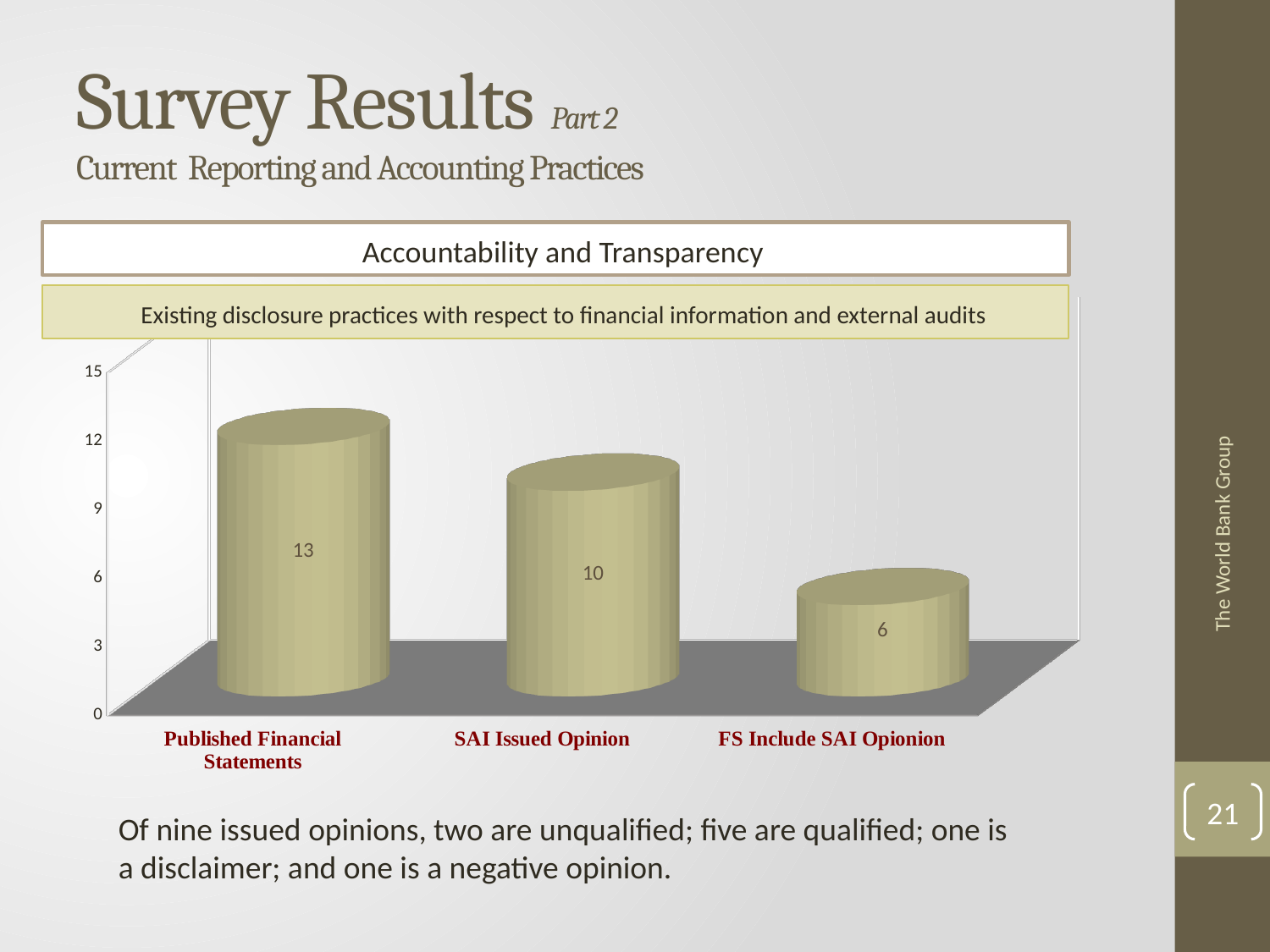
How many categories are shown in the chart? 3 What is the value for Published Financial Statements? 13 Which category has the highest value? Published Financial Statements What is the difference between the values for SAI Issued Opinion and FS Include SAI Opionion? 4 What is the value for FS Include SAI Opionion? 6 What is the difference between the values for Published Financial Statements and SAI Issued Opinion? 3 Which is larger, the value for SAI Issued Opinion or the value for FS Include SAI Opionion? SAI Issued Opinion What kind of chart is shown on the slide? bar chart Do the values rise or fall from left to right along the x axis? fall What is the value for SAI Issued Opinion? 10 Which category has the lowest value? FS Include SAI Opionion